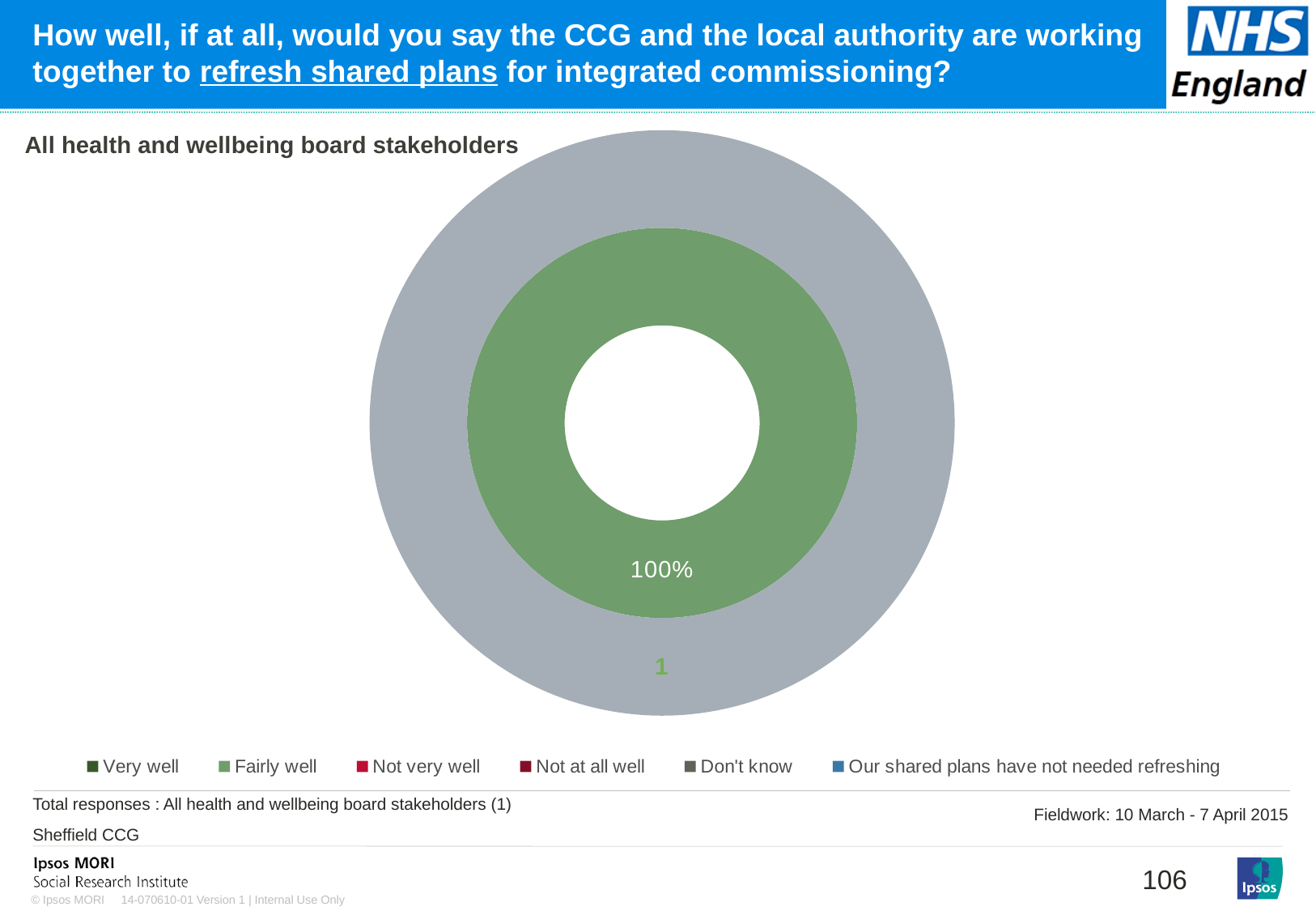
Is the share for 'Fairly well' greater or less than 50%? greater Which response category does the 100% slice represent? Fairly well What share of the doughnut does the 'Fairly well' slice take up? 100% What is the total number of responses shown for all health and wellbeing board stakeholders? 1 What is the subtitle above the chart describing the respondent group? All health and wellbeing board stakeholders What kind of chart is shown on the slide? Doughnut (pie) chart What is the last entry listed in the legend? Our shared plans have not needed refreshing How many entries does the legend list? 6 What percentage is shown on the green slice of the doughnut chart? 100% Which response category has the highest share in the chart? Fairly well